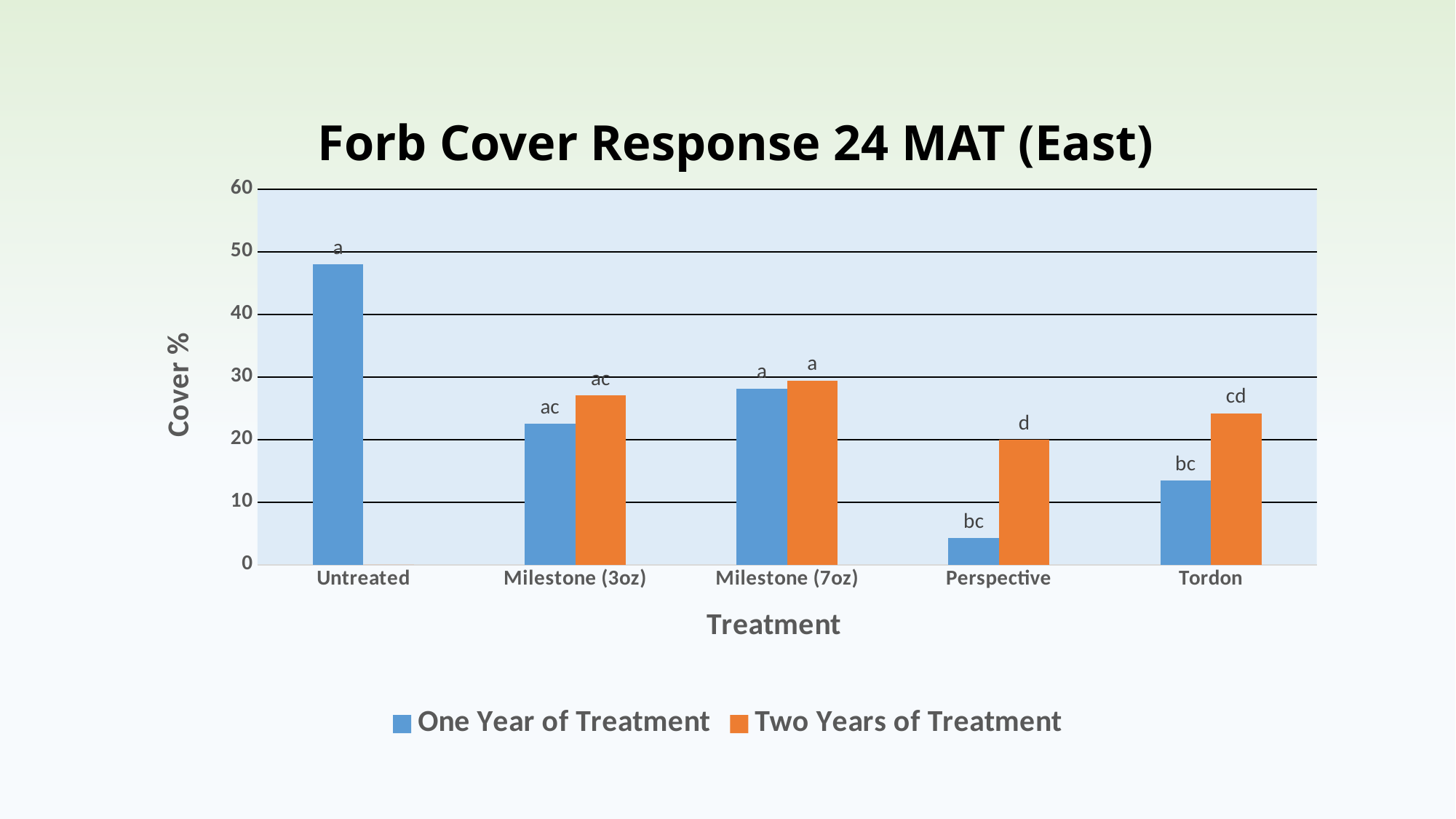
What kind of chart is shown on the slide? bar chart Is the Two Years of Treatment value for Milestone (3oz) greater or less than 30? less How many series does the legend list? 2 What is the label on the y axis? Cover % For Perspective, which is larger: the One Year of Treatment value or the Two Years of Treatment value? Two Years of Treatment Which treatment has the highest One Year of Treatment value? Untreated Is the One Year of Treatment value for Tordon greater or less than 20? less Is the One Year of Treatment value for Untreated greater or less than 40? greater Which treatment has the lowest One Year of Treatment value? Perspective How many treatment categories are shown on the x axis? 5 What is the title of the chart? Forb Cover Response 24 MAT (East)